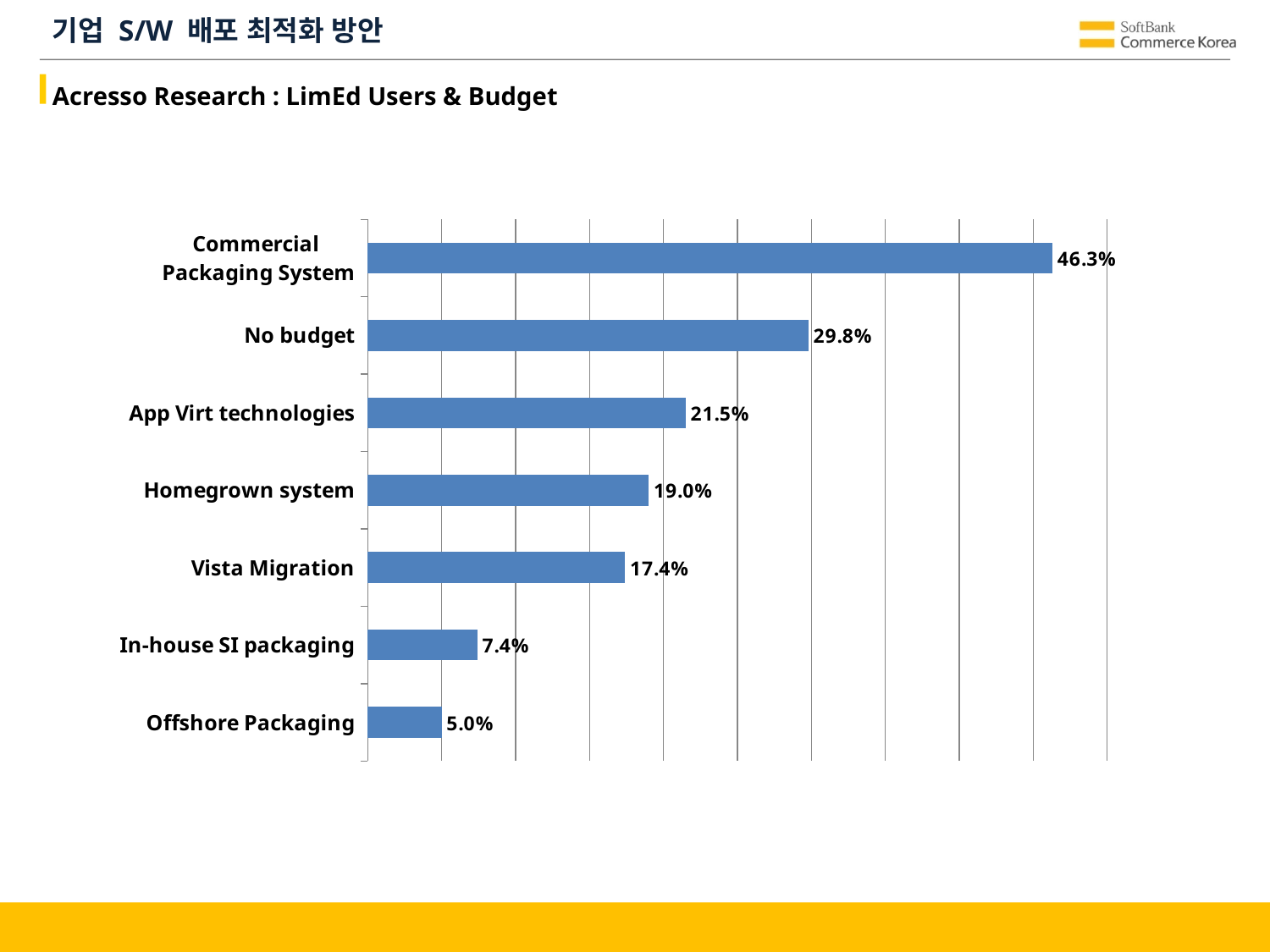
What is the value for No budget? 29.8% What is the title of the chart section on the slide? Acresso Research : LimEd Users & Budget Which category has the lowest value? Offshore Packaging How many categories are shown in the chart? 7 What is the difference between the values for Commercial Packaging System and No budget? 16.5% Which category has the highest value? Commercial Packaging System What is the value for Vista Migration? 17.4% What is the difference between the values for In-house SI packaging and Offshore Packaging? 2.4% What is the value for App Virt technologies? 21.5% Which is larger, the value for Homegrown system or the value for Vista Migration? Homegrown system What is the value for Commercial Packaging System? 46.3% What kind of chart is shown on the slide? Bar chart